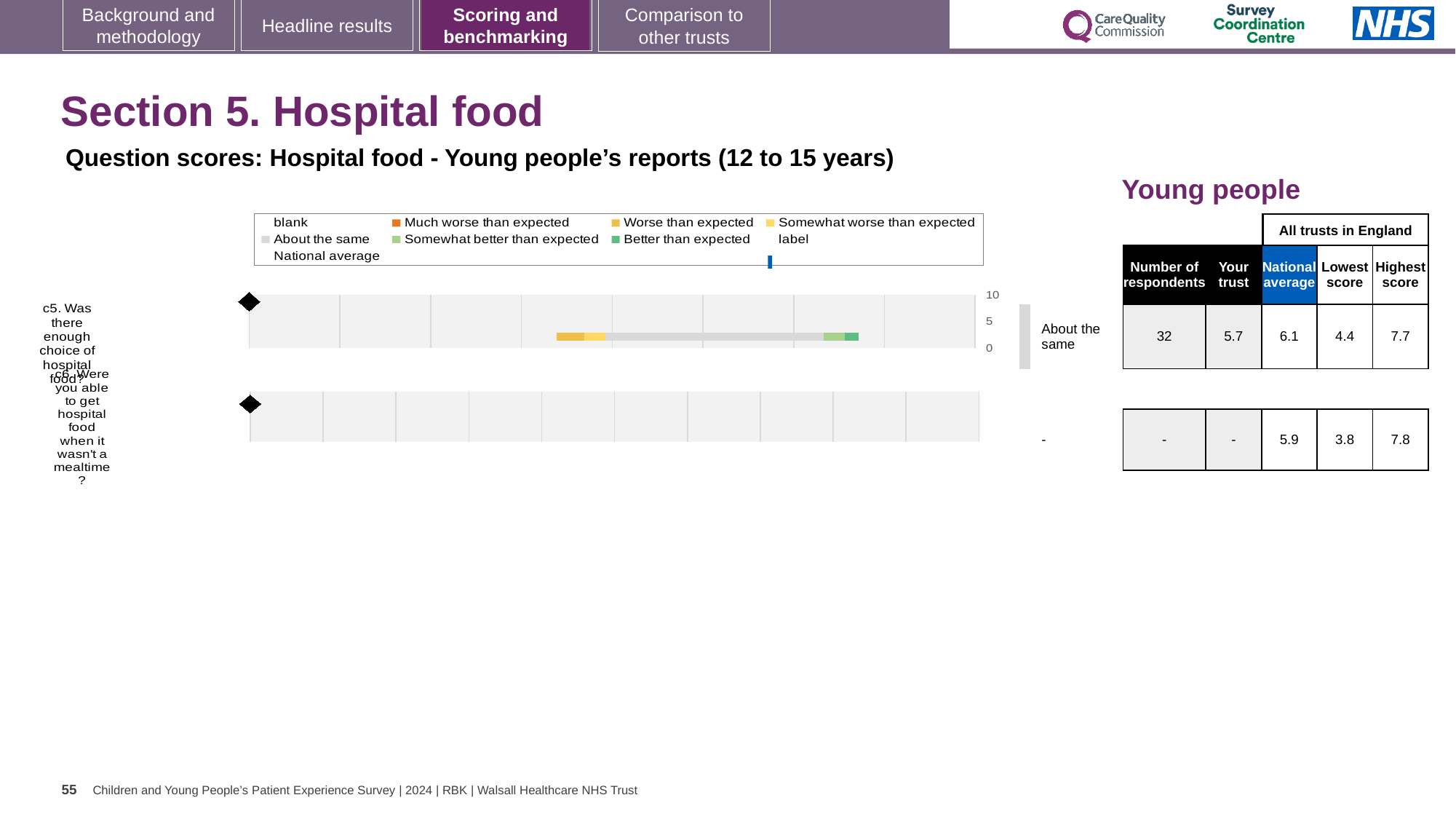
What is the difference between the highest score (7.7) and the lowest score (4.4) for question c5? 3.3 What is the highest score across all trusts in England for question c5? 7.7 What colour represents 'Better than expected' in the chart legend? Green In the table beside the chart, what is the national average for question c5? 6.1 How many entries does the chart legend list? 9 How many questions (categories) are plotted on the chart? 2 For question c5, which is larger: the 'Your trust' score or the national average? National average In the table beside the chart, what is the 'Your trust' score for question c5 (enough choice of hospital food)? 5.7 What benchmark category is shown for question c5 next to the chart? About the same How many respondents answered question c5 according to the table beside the chart? 32 What kind of chart is used to show the question scores for hospital food? Bar chart What is the maximum value shown on the chart's score axis? 10